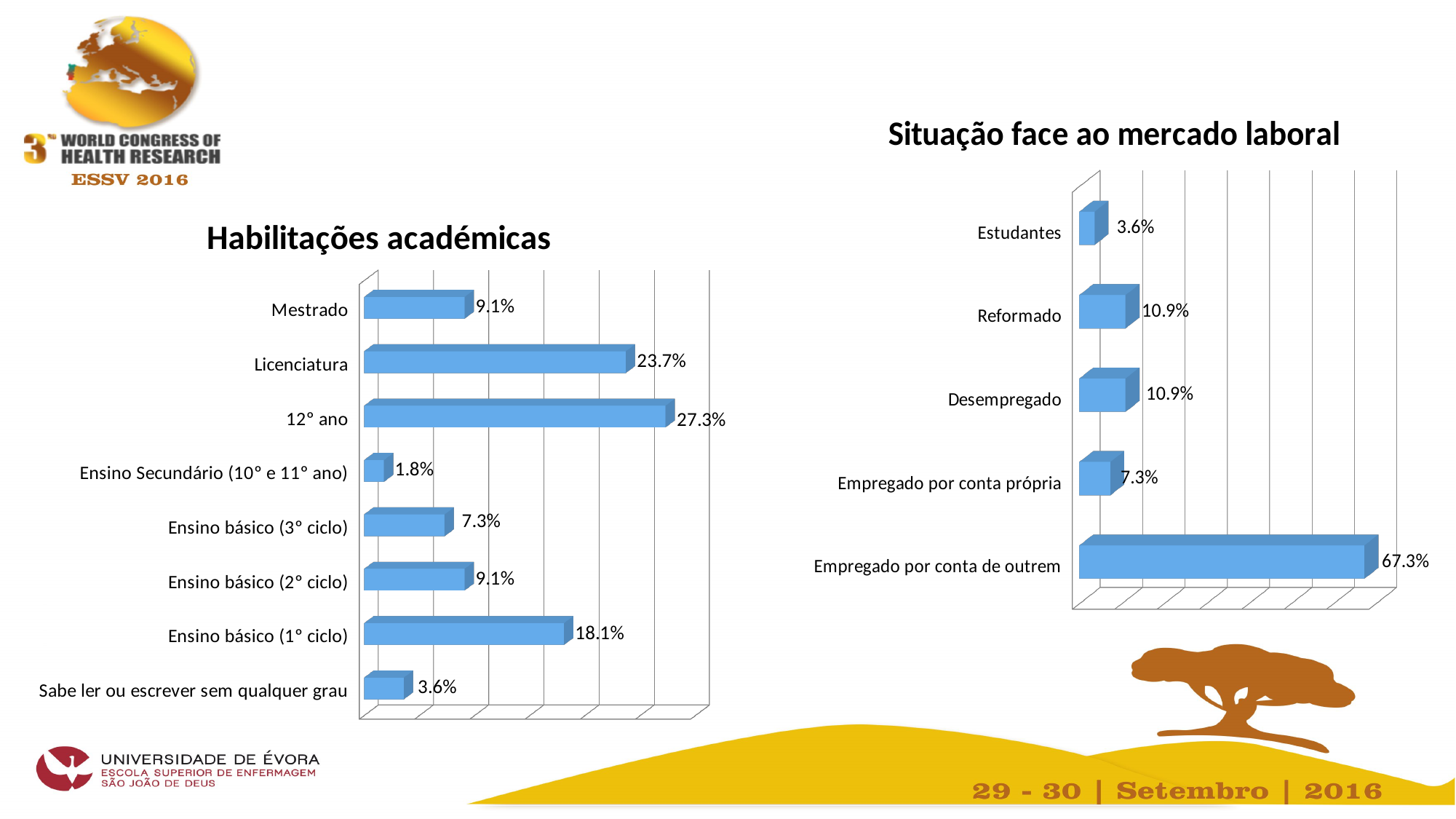
In the 'Situação face ao mercado laboral' chart, which category has the lowest value? Estudantes In the 'Situação face ao mercado laboral' chart, what is the difference between Empregado por conta de outrem and Desempregado? 56.4% In the 'Habilitações académicas' chart, what is the difference between 12° ano and Licenciatura? 3.6% In the 'Habilitações académicas' chart, what is the value for Ensino básico (1° ciclo)? 18.1% In the 'Habilitações académicas' chart, which category has the highest value? 12° ano In the 'Habilitações académicas' chart, how many categories are shown? 8 In the 'Situação face ao mercado laboral' chart, how many categories are shown? 5 In the 'Habilitações académicas' chart, what is the value for Licenciatura? 23.7% In the 'Situação face ao mercado laboral' chart, what is the value for Empregado por conta de outrem? 67.3% In the 'Habilitações académicas' chart, which category has the lowest value? Ensino Secundário (10° e 11° ano) What kind of chart is the 'Habilitações académicas' chart? Bar chart In the 'Situação face ao mercado laboral' chart, which is larger: Reformado or Empregado por conta própria? Reformado